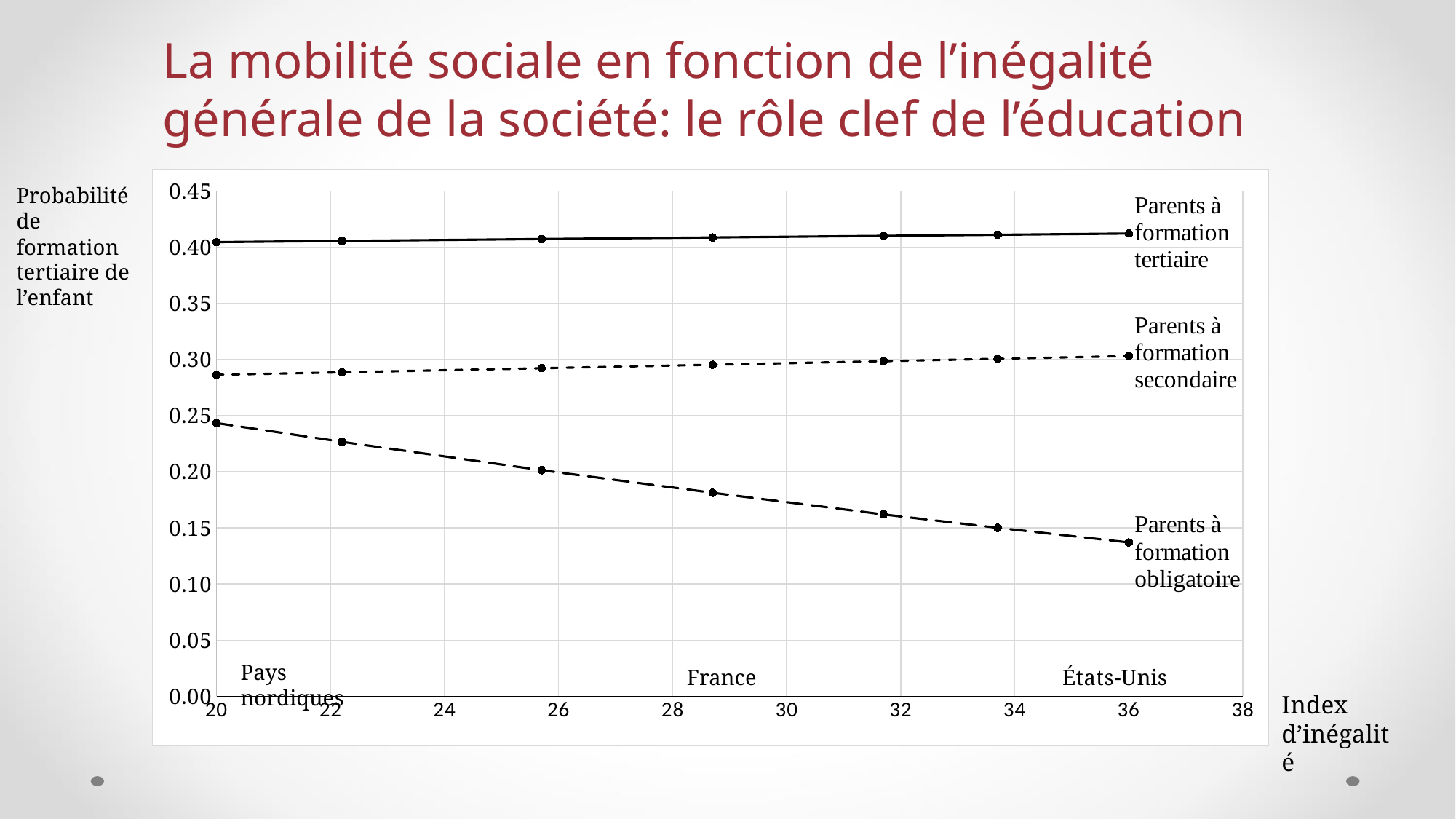
Does the 'Parents à formation tertiaire' line rise or fall as the index d'inégalité increases? rise Which series has the lowest values across the whole chart? Parents à formation obligatoire Which country label is placed near index 36 on the x axis? États-Unis Is the value for 'Parents à formation obligatoire' at index 36 greater or less than 0.15? less What kind of chart is shown on the slide? line chart How many series are plotted on the chart? 3 How many data points does the 'Parents à formation obligatoire' series have? 7 Does the 'Parents à formation obligatoire' line rise or fall as the index d'inégalité increases? fall Is the value for 'Parents à formation tertiaire' at index 36 greater or less than 0.35? greater Is the value for 'Parents à formation obligatoire' at index 20 greater or less than 0.20? greater At index 36, which series has the larger value: 'Parents à formation tertiaire' or 'Parents à formation obligatoire'? Parents à formation tertiaire